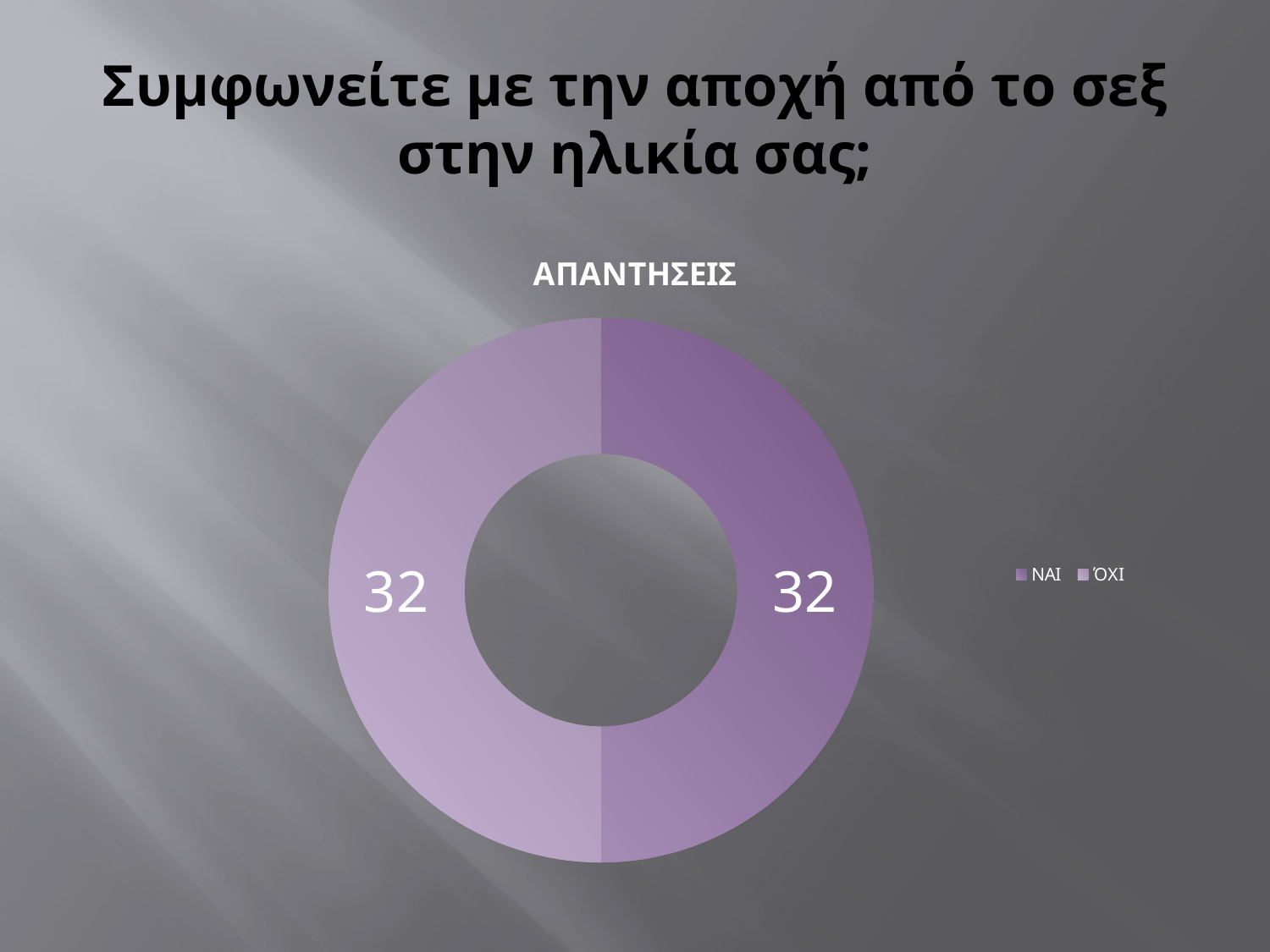
What share of the chart does the ΝΑΙ slice represent? 50% What is the value for ΌΧΙ in the chart? 32 What is the value for ΝΑΙ in the chart? 32 What share of the chart does the ΌΧΙ slice represent? 50% What is the total of the values shown in the chart? 64 Is the value for ΝΑΙ larger than, smaller than, or equal to the value for ΌΧΙ? Equal What kind of chart is shown on the slide? Doughnut chart How many entries does the chart's legend list? 2 What is the title of the chart? ΑΠΑΝΤΗΣΕΙΣ How many categories does the chart show? 2 Which legend entry is listed first in the chart's legend? ΝΑΙ What is the difference between the values for ΝΑΙ and ΌΧΙ? 0